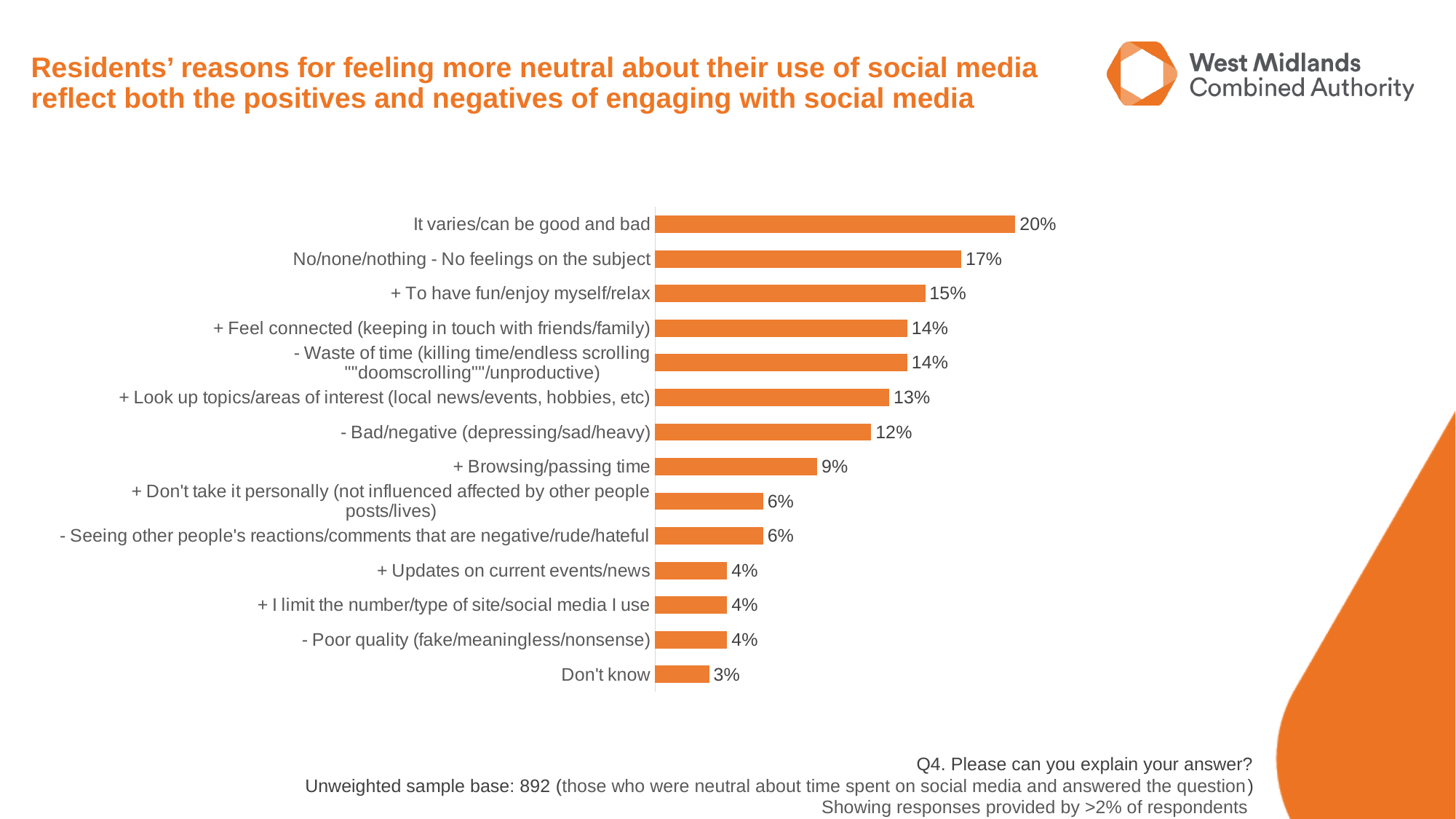
What percentage is shown for '- Bad/negative (depressing/sad/heavy)'? 12% Which is larger: '+ Browsing/passing time' or '+ Look up topics/areas of interest (local news/events, hobbies, etc)'? + Look up topics/areas of interest (local news/events, hobbies, etc) What is the unweighted sample base stated on the slide? 892 What is the value for '+ To have fun/enjoy myself/relax'? 15% What is the difference between '+ Feel connected (keeping in touch with friends/family)' and '+ Updates on current events/news'? 10% What percentage of respondents gave 'It varies/can be good and bad' as a reason? 20% What type of chart is shown on the slide? Bar chart Which reason has the highest percentage? It varies/can be good and bad What is the difference between 'It varies/can be good and bad' and 'No/none/nothing - No feelings on the subject'? 3% What is the value for 'Don't know'? 3% How many categories are shown in the chart? 14 Which category has the lowest percentage? Don't know